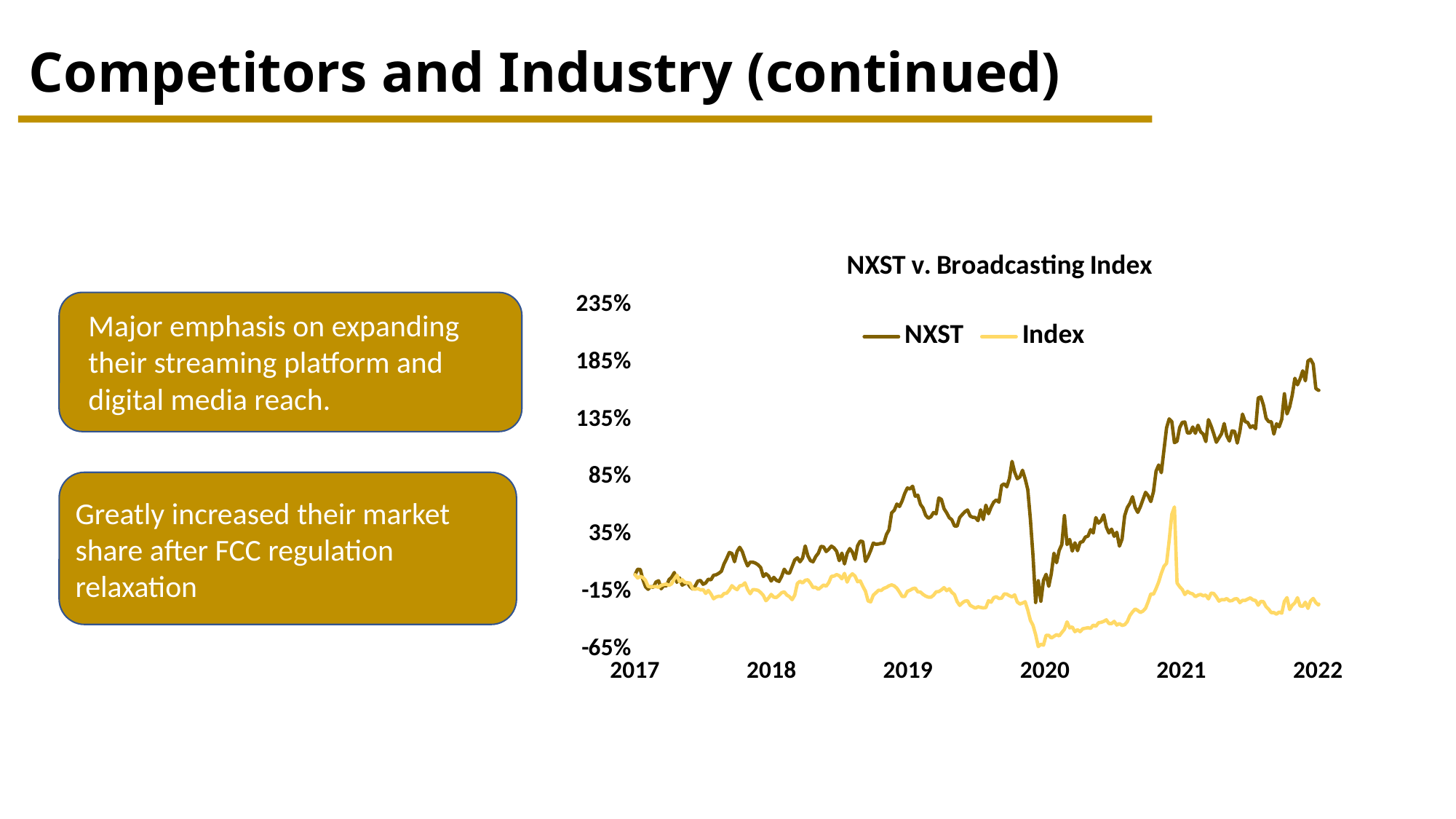
Does the NXST line rise or fall overall from 2017 to 2022? rise Is the value for NXST at 2021 greater or less than 85%? greater Is the value for NXST at 2019 greater or less than 35%? greater Is the value for Index at 2020 greater or less than -15%? less What kind of chart is shown on the slide? line chart What are the two series named in the chart's legend? NXST and Index At 2022, which series has the higher value, NXST or Index? NXST What is the title of the chart? NXST v. Broadcasting Index How many year labels are shown along the x axis of the chart? 6 How many series does the chart's legend list? 2